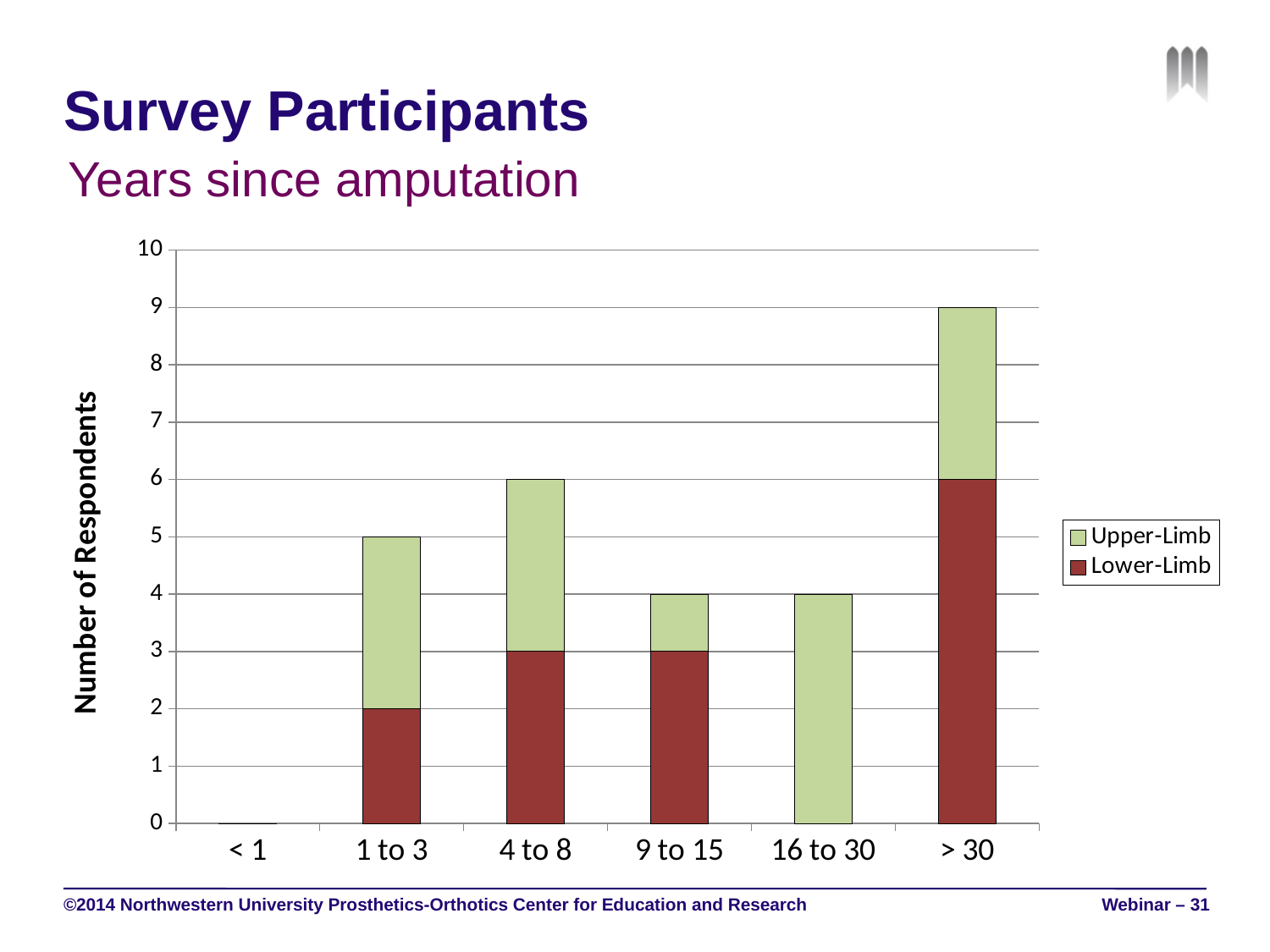
How many series does the legend list? 2 What is the total number of respondents for the 1 to 3 category? 5 What is the Lower-Limb value for the > 30 category? 6 Which category has the highest total number of respondents? > 30 What is the difference between the total for > 30 and the total for 4 to 8? 3 How many categories are shown on the x axis? 6 What kind of chart is shown on the slide? bar chart Which category has a larger total number of respondents, 1 to 3 or 9 to 15? 1 to 3 What is the title of the y axis? Number of Respondents What is the total number of respondents for the 4 to 8 category? 6 What is the Lower-Limb value for the 4 to 8 category? 3 What is the Upper-Limb value for the 16 to 30 category? 4